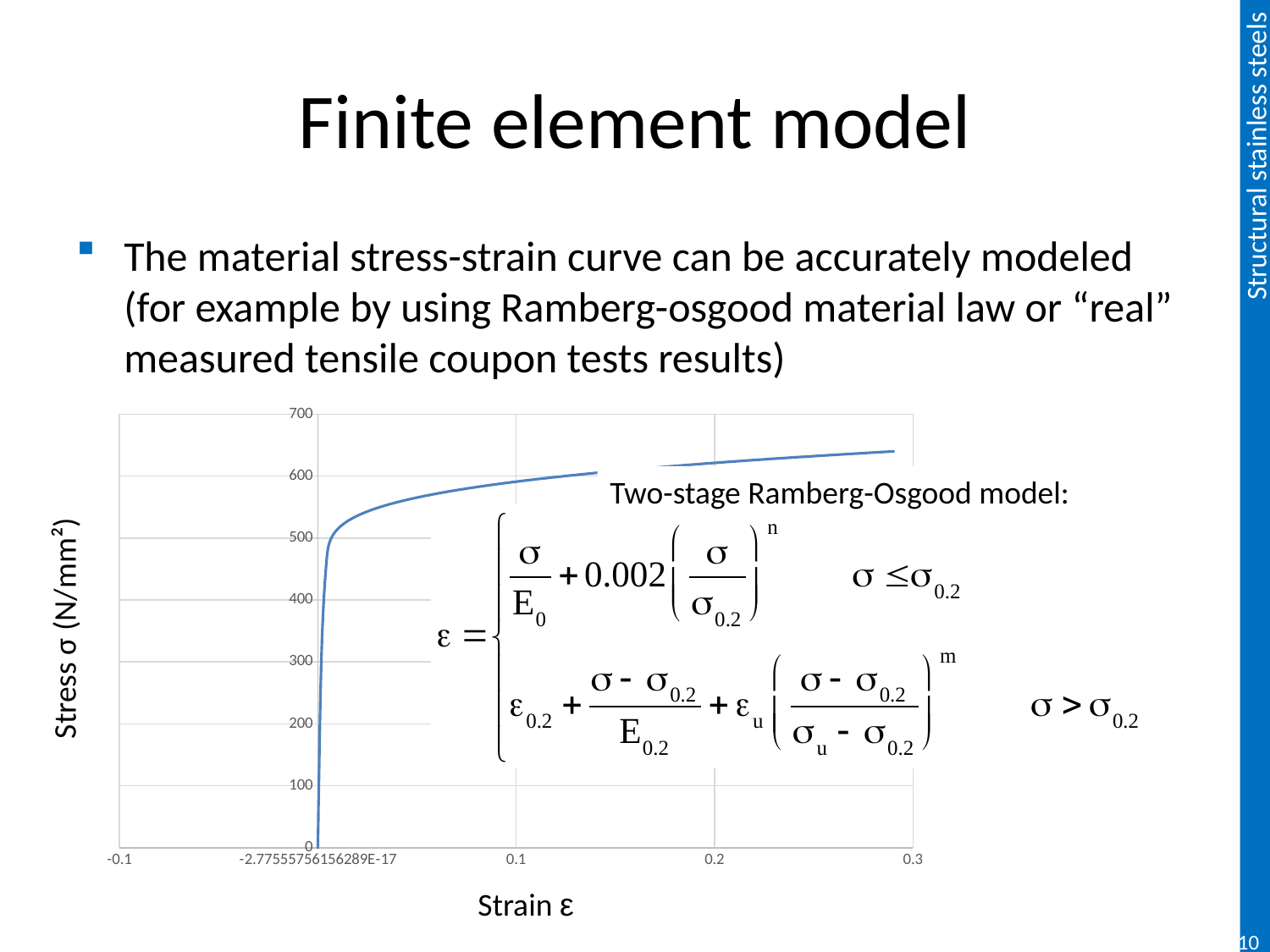
What is the label of the vertical axis of the chart? Stress σ (N/mm²) Does the stress value rise or fall as strain increases along the x axis? rise Is the stress value at a strain of 0.1 greater or less than 500? greater What kind of chart is shown on the slide? line chart What is the highest value shown on the horizontal axis of the chart? 0.3 Which is larger, the stress at a strain of 0.1 or the stress at a strain of 0.2? the stress at a strain of 0.2 What is the label of the horizontal axis of the chart? Strain ε Is the stress value at a strain of 0.2 greater or less than 700? less Is the highest stress value reached by the curve greater or less than 700? less What is the highest value shown on the vertical axis of the chart? 700